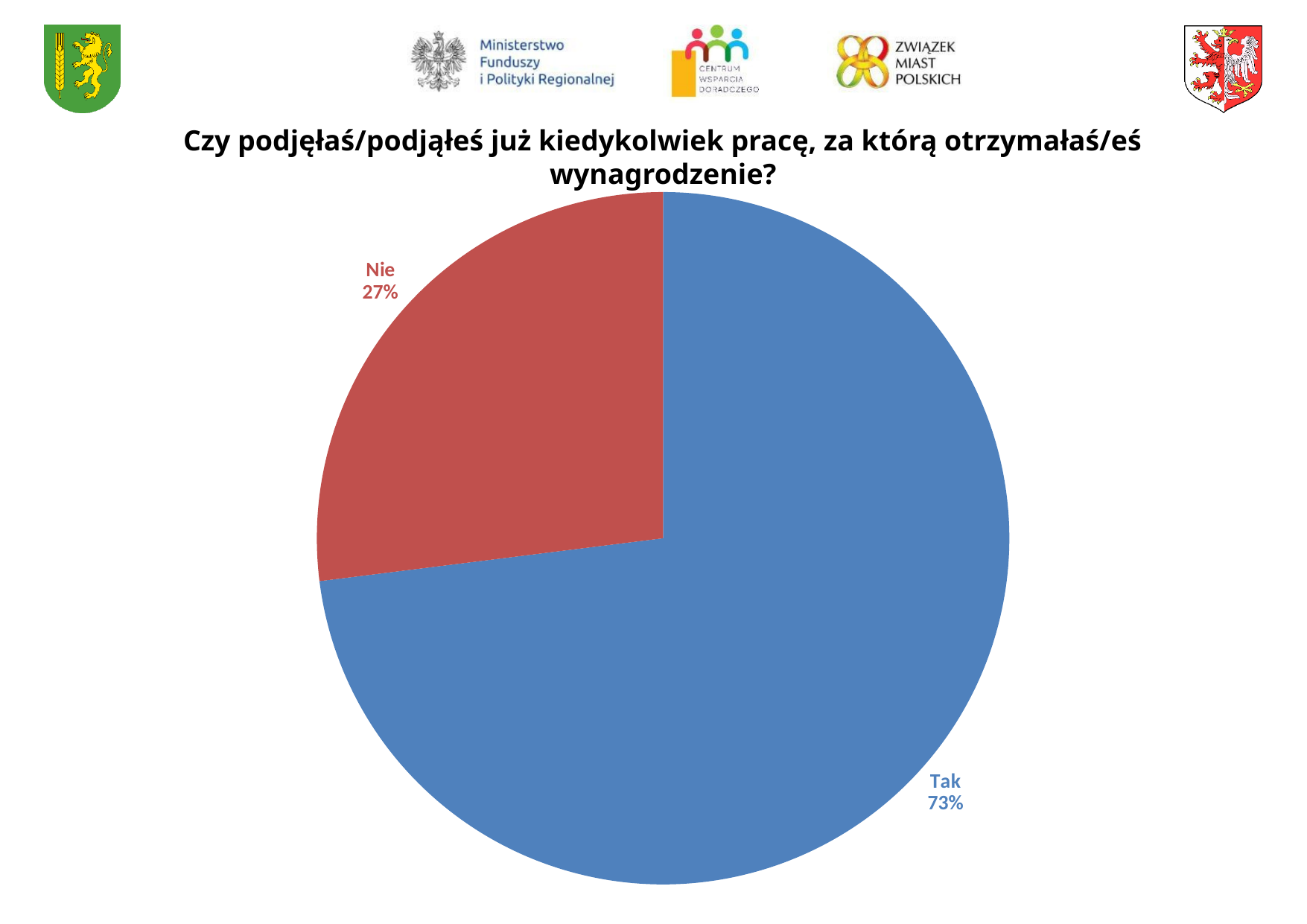
Which slice is the largest in the pie chart? Tak What share of the pie does the "Nie" slice represent? 27% What colour is the "Nie" slice? red What is the difference in percentage points between the "Tak" and "Nie" slices? 46 Which is larger, the "Tak" slice or the "Nie" slice? Tak What is the title of the chart? Czy podjęłaś/podjąłeś już kiedykolwiek pracę, za którą otrzymałaś/eś wynagrodzenie? What is the total of the two slice percentages shown? 100% How many slices does the pie chart have? 2 Which slice is the smallest in the pie chart? Nie What share of the pie does the "Tak" slice represent? 73% What kind of chart is shown on the slide? pie chart